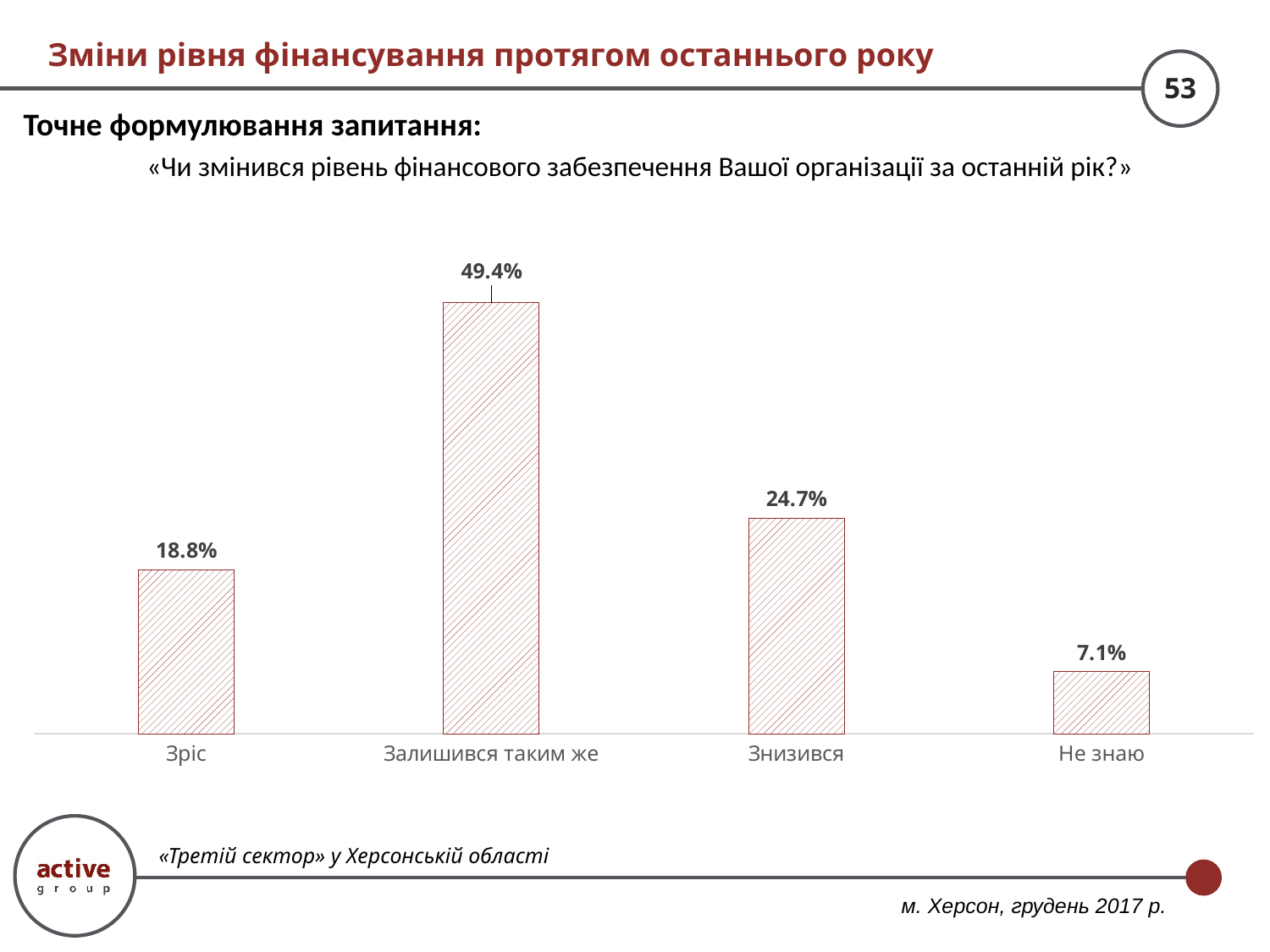
What is the value for "Залишився таким же"? 49.4% What kind of chart is shown on the slide? Bar chart What is the value for "Зріс"? 18.8% How many categories are shown on the chart? 4 What is the value for "Не знаю"? 7.1% Which category has the highest value? Залишився таким же What is the value for "Знизився"? 24.7% What is the title of the slide containing the chart? Зміни рівня фінансування протягом останнього року What is the difference between the values for "Знизився" and "Зріс"? 5.9% Which category has the lowest value? Не знаю What is the difference between the values for "Залишився таким же" and "Знизився"? 24.7% Which is larger, the value for "Знизився" or the value for "Зріс"? Знизився